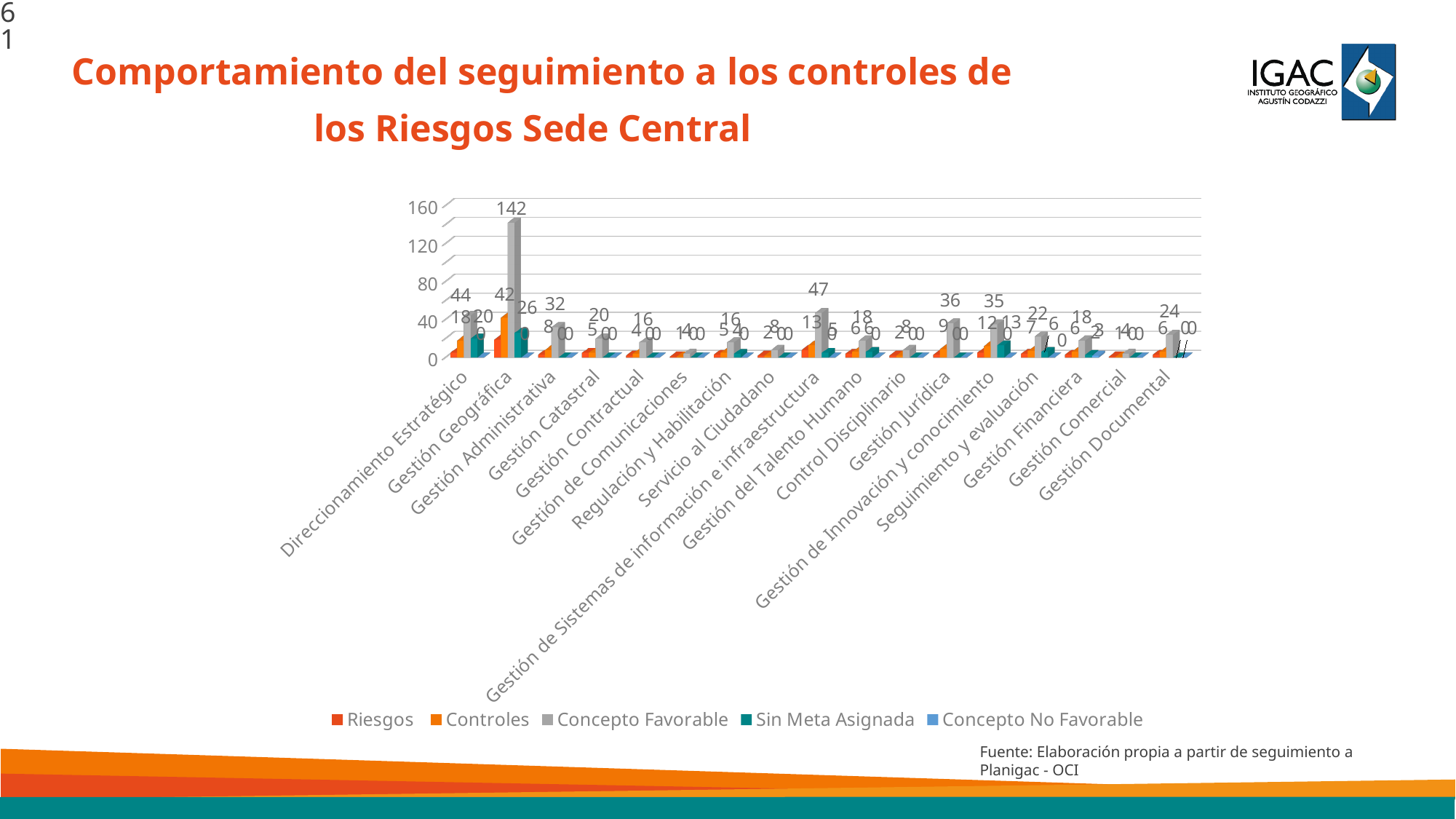
Is the Concepto Favorable value for Gestión de Sistemas de información e infraestructura greater or less than 80? less Which is larger, the Concepto Favorable value for Gestión Geográfica or for Gestión de Sistemas de información e infraestructura? Gestión Geográfica What is the highest value labelled in the chart? 142 What is the title of the chart on the slide? Comportamiento del seguimiento a los controles de los Riesgos Sede Central What is the difference between the Concepto Favorable value for Gestión Geográfica (142) and for Gestión de Sistemas de información e infraestructura (47)? 95 How many categories are shown along the x axis of the chart? 17 What kind of chart is shown on the slide? bar chart Which category has the tallest bar in the chart? Gestión Geográfica Which colour represents the Concepto Favorable series in the legend? gray What is the Concepto Favorable value for Gestión Geográfica? 142 How many series does the legend list? 5 Is the Concepto Favorable value for Gestión Geográfica greater or less than 120? greater